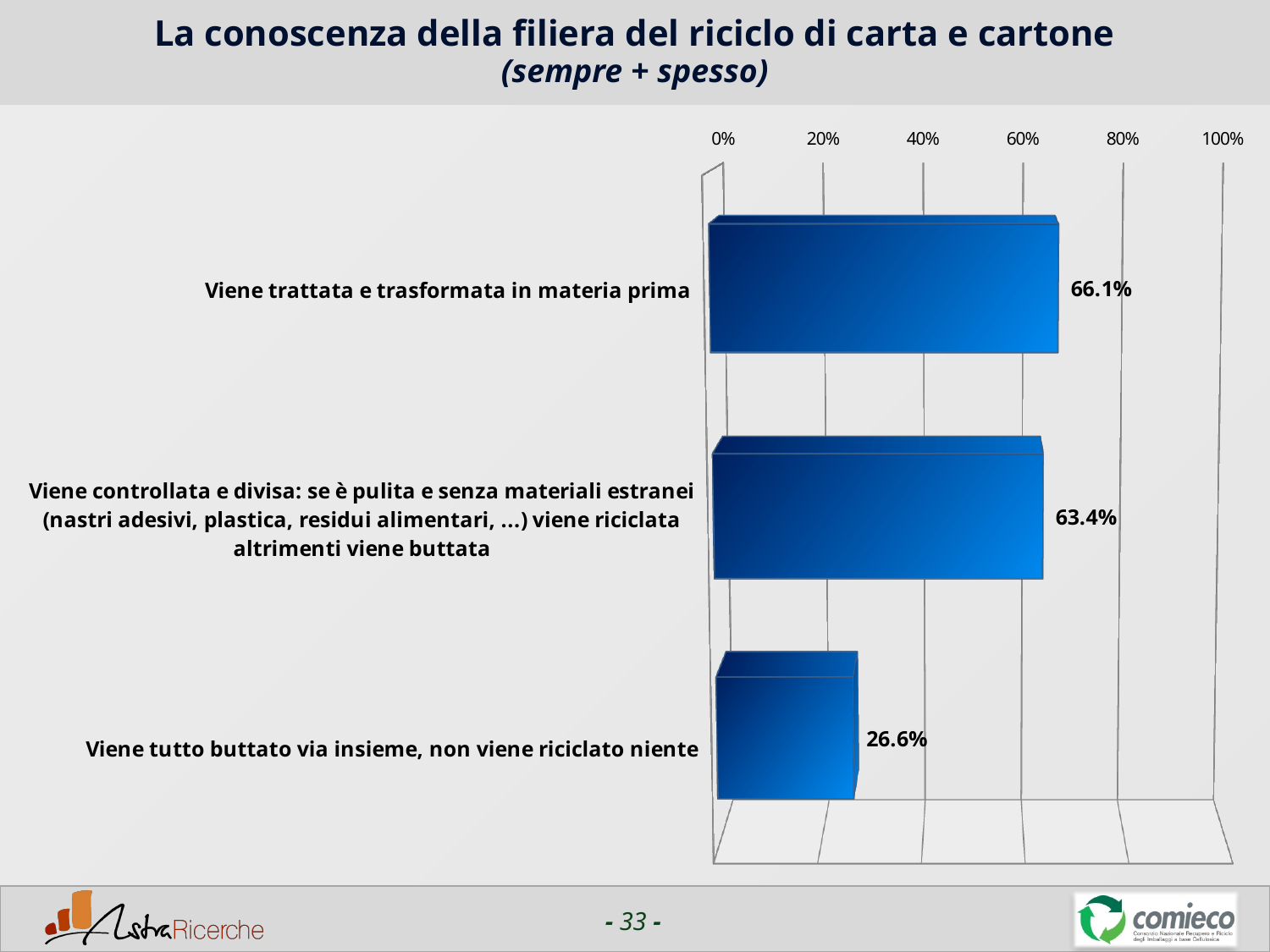
What is the title of the slide? La conoscenza della filiera del riciclo di carta e cartone (sempre + spesso) Is the value for "Viene tutto buttato via insieme, non viene riciclato niente" greater or less than 40%? less What is the difference between the values for "Viene trattata e trasformata in materia prima" and "Viene tutto buttato via insieme, non viene riciclato niente"? 39.5% What is the difference between the values for "Viene trattata e trasformata in materia prima" and "Viene controllata e divisa..."? 2.7% What is the value for "Viene tutto buttato via insieme, non viene riciclato niente"? 26.6% Which is larger: the value for "Viene controllata e divisa..." or the value for "Viene tutto buttato via insieme, non viene riciclato niente"? Viene controllata e divisa... What is the value for "Viene controllata e divisa: se è pulita e senza materiali estranei (nastri adesivi, plastica, residui alimentari, ...) viene riciclata altrimenti viene buttata"? 63.4% Which category has the highest value? Viene trattata e trasformata in materia prima Which category has the lowest value? Viene tutto buttato via insieme, non viene riciclato niente What kind of chart is shown on the slide? bar chart What is the value for "Viene trattata e trasformata in materia prima"? 66.1% How many categories are shown in the chart? 3